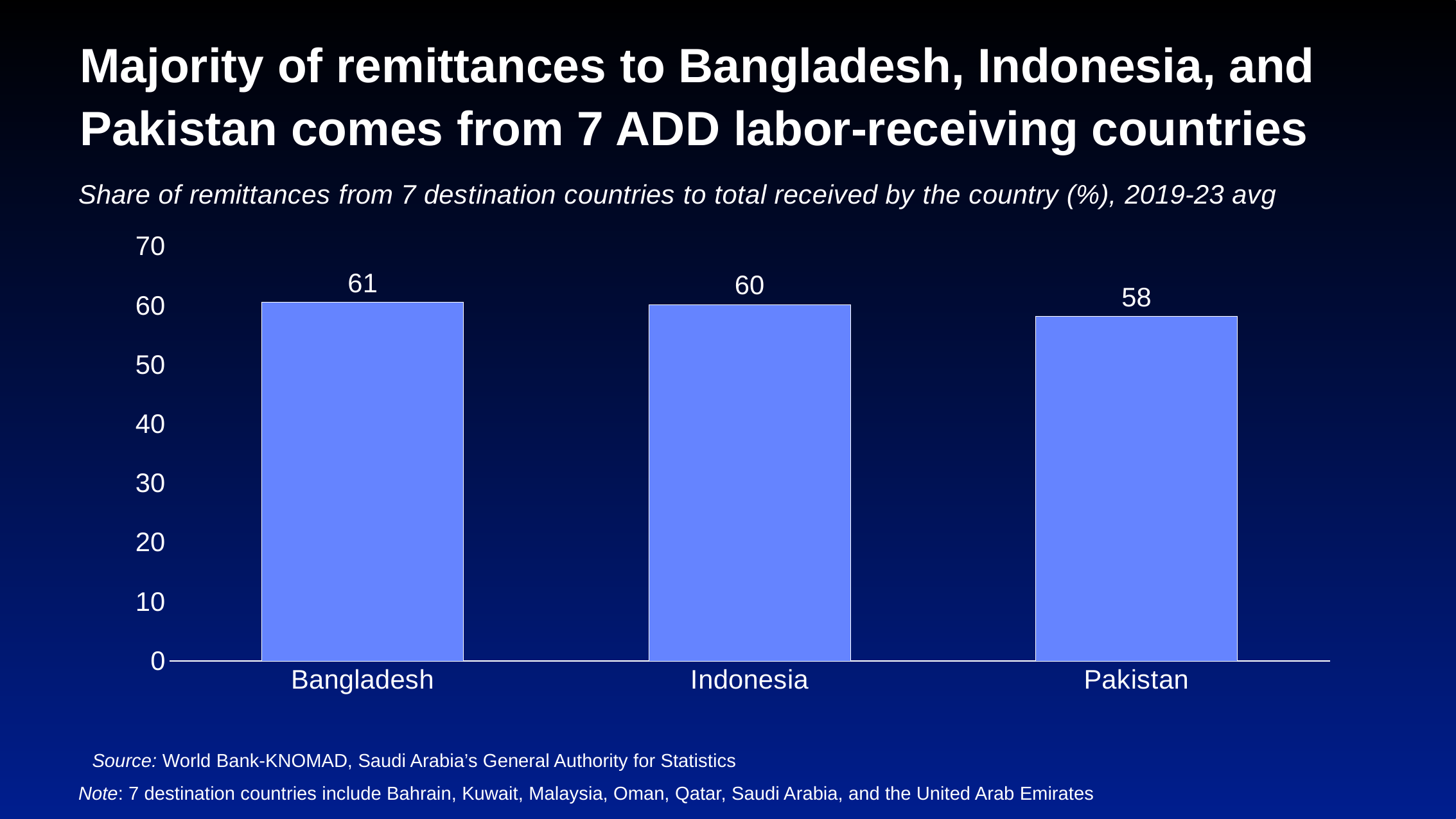
What is the difference between the values for Bangladesh and Pakistan? 3 What is the value for Pakistan? 58 Is the value for Pakistan greater or less than 50? greater What is the difference between the values for Indonesia and Pakistan? 2 What is the value for Indonesia? 60 How many countries are shown in the chart? 3 What period do the values in the chart average over, according to the chart subtitle? 2019-23 Which country has the highest share of remittances from the 7 destination countries? Bangladesh What kind of chart is shown on the slide? bar chart Which is larger, the value for Bangladesh or the value for Pakistan? Bangladesh Which country has the lowest share of remittances from the 7 destination countries? Pakistan What is the value for Bangladesh? 61